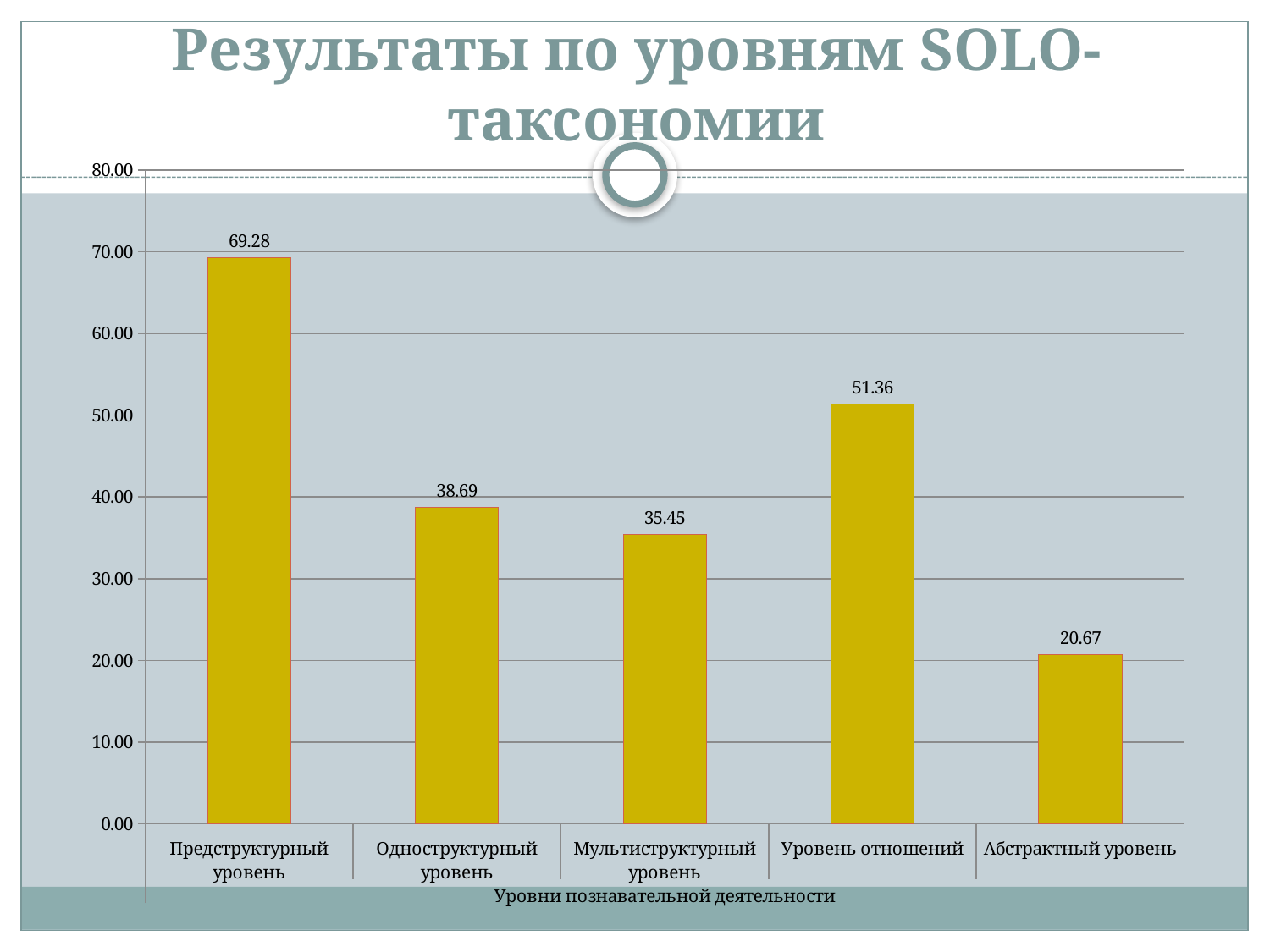
What kind of chart is shown on the slide? bar chart What is the difference between the values for Одноструктурный уровень and Мультиструктурный уровень? 3.24 Is the value for Мультиструктурный уровень greater or less than 40.00? less What is the value for Абстрактный уровень? 20.67 Which category has the lowest value? Абстрактный уровень What is the value for Уровень отношений? 51.36 How many categories are shown on the x axis? 5 What is the value for Предструктурный уровень? 69.28 What is the x-axis title of the chart? Уровни познавательной деятельности What is the difference between the values for Предструктурный уровень and Абстрактный уровень? 48.61 Which category has the highest value? Предструктурный уровень Which is larger, the value for Уровень отношений or the value for Одноструктурный уровень? Уровень отношений